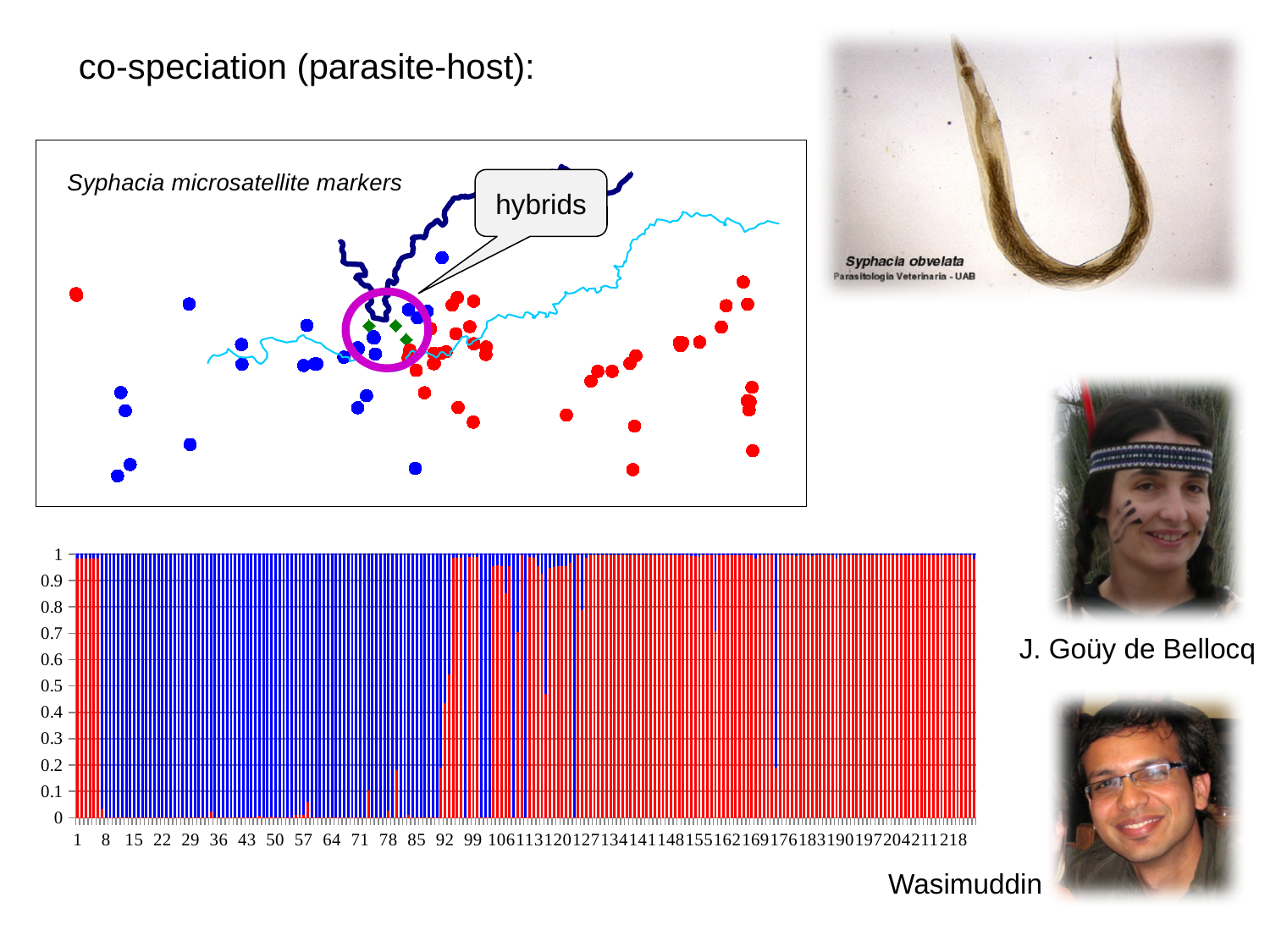
On the bottom bar chart, what is the highest value shown on the y-axis? 1 On the bottom bar chart, what is the total height of each stacked bar? 1 On the bottom bar chart, what is the interval between consecutive y-axis tick labels? 0.1 On the bottom bar chart, which colour dominates the bars on the left side of the chart? blue On the bottom bar chart, what is the last x-axis tick label? 218 How many tick labels are shown on the y-axis of the bottom bar chart? 11 What kind of chart is the chart at the bottom of the slide? bar chart On the bottom bar chart, what is the step between consecutive x-axis tick labels? 7 On the bottom bar chart, what is the lowest value shown on the y-axis? 0 On the bottom bar chart, what is the first x-axis tick label? 1